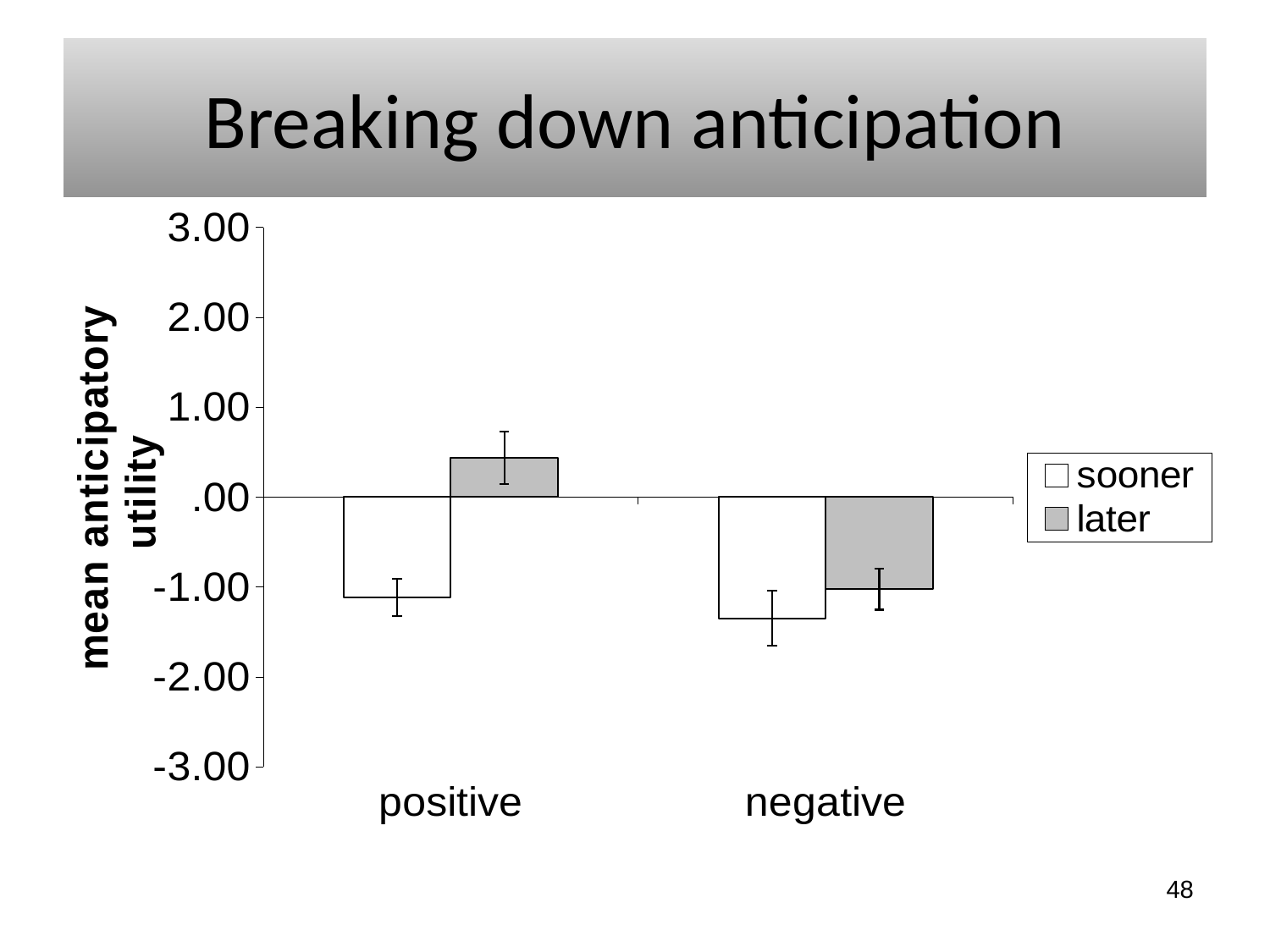
What is the label of the y axis? mean anticipatory utility Is the value for 'sooner' in the negative category greater or less than -1.00? less How many series does the legend list? 2 Is the value for 'later' in the positive category greater or less than 1.00? less What are the two series listed in the legend? sooner and later Which bar has the highest value on the chart? later, positive How many categories are shown on the x axis? 2 Is the value for 'later' in the negative category greater or less than 0.00? less Which bar has the lowest value on the chart? sooner, negative What kind of chart is shown on the slide? bar chart In the negative category, which series has the larger value, sooner or later? later